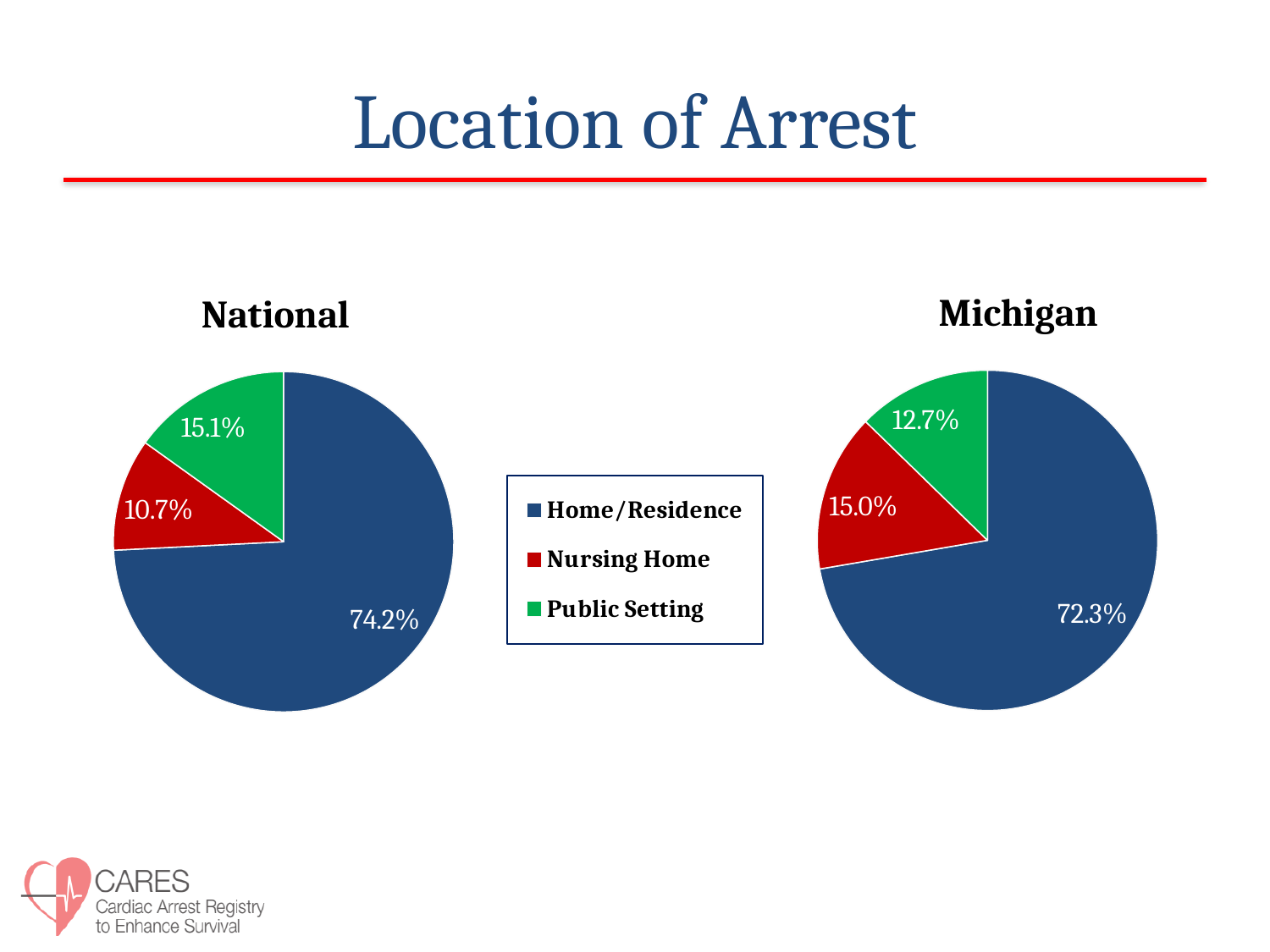
In the Michigan pie chart, which location has the smallest share? Public Setting What colour represents Nursing Home in the legend? Red In the National pie chart, which location has the smallest share? Nursing Home In the Michigan pie chart, what share of arrests occurred in a Nursing Home? 15.0% In the Michigan pie chart, what share of arrests occurred in a Public Setting? 12.7% How many categories does the legend list? 3 In the Michigan pie chart, which location has the largest share? Home/Residence What type of chart is used on this slide? Pie chart What is the difference between the Home/Residence share in the National chart and in the Michigan chart? 1.9% In the National pie chart, what share of arrests occurred at Home/Residence? 74.2% In the National pie chart, what share of arrests occurred in a Public Setting? 15.1% Which is larger: the Nursing Home share in the National chart or in the Michigan chart? Michigan